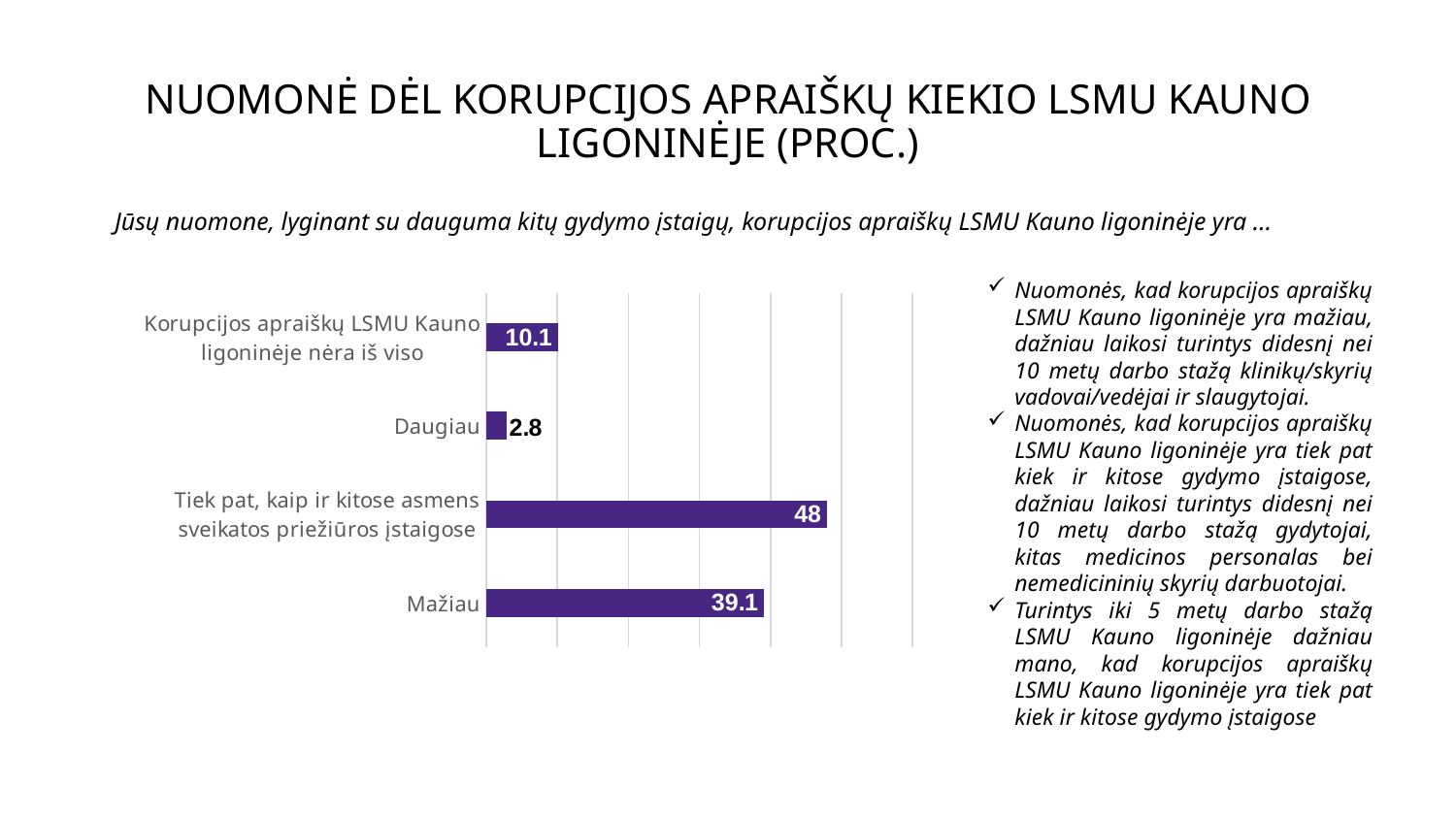
What is the difference between the values for "Korupcijos apraiškų LSMU Kauno ligoninėje nėra iš viso" and "Daugiau"? 7.3 What is the value for "Korupcijos apraiškų LSMU Kauno ligoninėje nėra iš viso"? 10.1 Which is larger, the value for "Mažiau" or the value for "Korupcijos apraiškų LSMU Kauno ligoninėje nėra iš viso"? Mažiau What kind of chart is shown on the slide? Bar chart Which category has the highest value? Tiek pat, kaip ir kitose asmens sveikatos priežiūros įstaigose Which category has the lowest value? Daugiau What is the value for "Tiek pat, kaip ir kitose asmens sveikatos priežiūros įstaigose"? 48 What colour are the bars in the chart? Purple What is the value for "Mažiau"? 39.1 What is the value for "Daugiau"? 2.8 How many categories are shown in the chart? 4 What is the difference between the values for "Tiek pat, kaip ir kitose asmens sveikatos priežiūros įstaigose" and "Mažiau"? 8.9